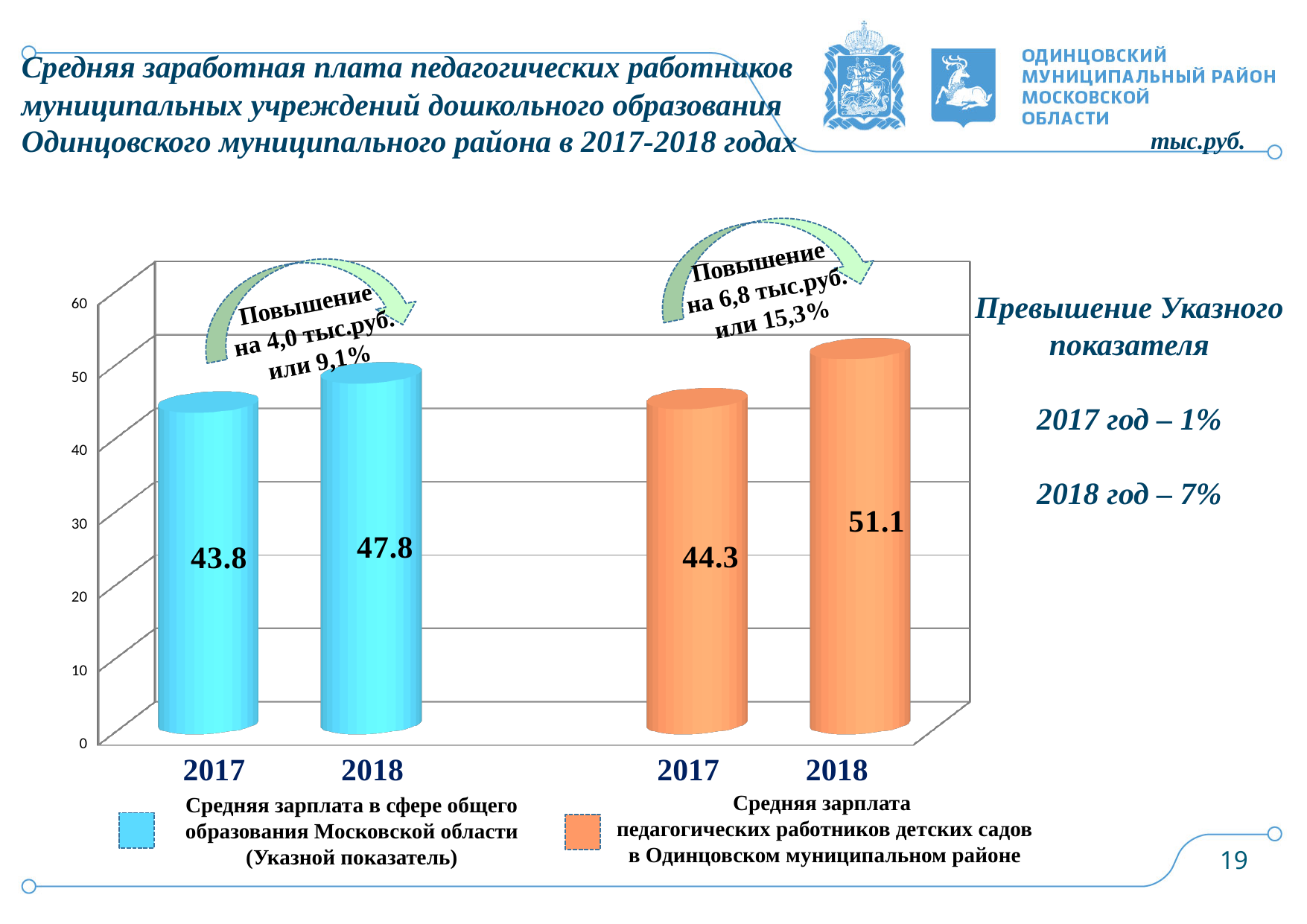
Which bar has the lowest value on the chart? 2017, Средняя зарплата в сфере общего образования Московской области (Указной показатель) (43.8) What is the value for 2017 for the series 'Средняя зарплата педагогических работников детских садов в Одинцовском муниципальном районе'? 44.3 In 2018, which series has the larger value: the Указной показатель series or the Одинцовский муниципальный район series? Одинцовский муниципальный район series (51.1) What is the value for 2018 for the series 'Средняя зарплата в сфере общего образования Московской области (Указной показатель)'? 47.8 What kind of chart is shown on the slide? Bar chart Which bar has the highest value on the chart? 2018, Средняя зарплата педагогических работников детских садов в Одинцовском муниципальном районе (51.1) What is the value for 2017 for the series 'Средняя зарплата в сфере общего образования Московской области (Указной показатель)'? 43.8 How many series does the legend list? 2 What is the difference between the 2018 and 2017 values for the series 'Средняя зарплата в сфере общего образования Московской области (Указной показатель)'? 4.0 What is the difference between the 2018 and 2017 values for the series 'Средняя зарплата педагогических работников детских садов в Одинцовском муниципальном районе'? 6.8 What is the value for 2018 for the series 'Средняя зарплата педагогических работников детских садов в Одинцовском муниципальном районе'? 51.1 Is the 2018 value for the Одинцовский муниципальный район series greater or less than 50? greater